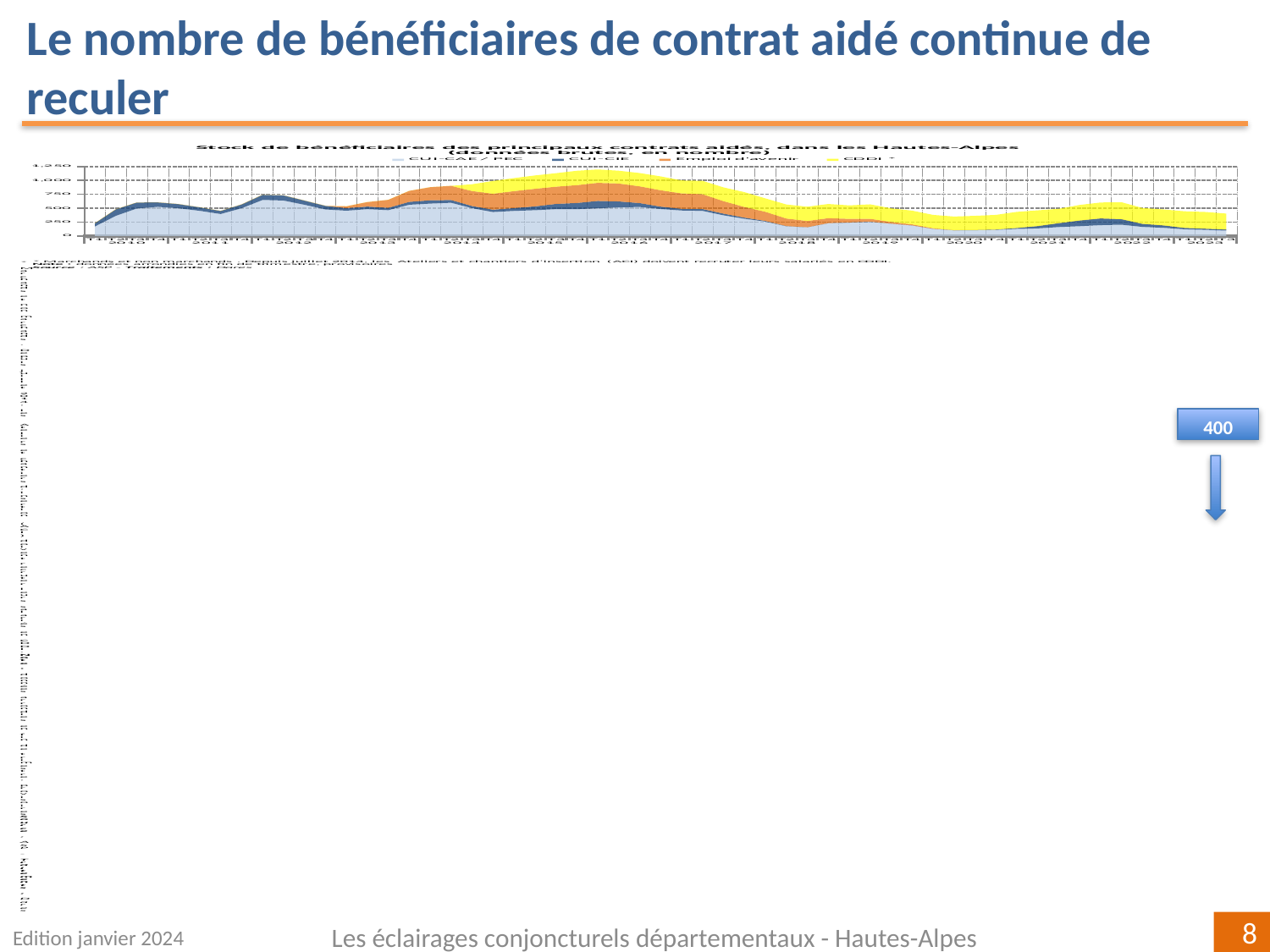
Is the total stock of beneficiaries in 2016 larger or smaller than in 2023? larger Which series are listed in the chart's legend? CUI-CAE / PEC, CUI-CIE, Emploi d'avenir, CDDI* Which year does the x axis of the chart end with? 2023 Does the total stock of beneficiaries rise or fall between 2016 and 2023? fall How many years are labelled along the x axis of the chart? 14 Which year does the x axis of the chart start with? 2010 Is the total stock of beneficiaries at its 2016 peak greater or less than 750? greater How many series does the chart's legend list? 4 What kind of chart is shown on the slide? Stacked area chart Is the total stock of beneficiaries at the end of 2023 greater or less than 500? less In which year does the total stock of beneficiaries reach its peak? 2016 What is the highest value shown on the chart's vertical axis? 1.250